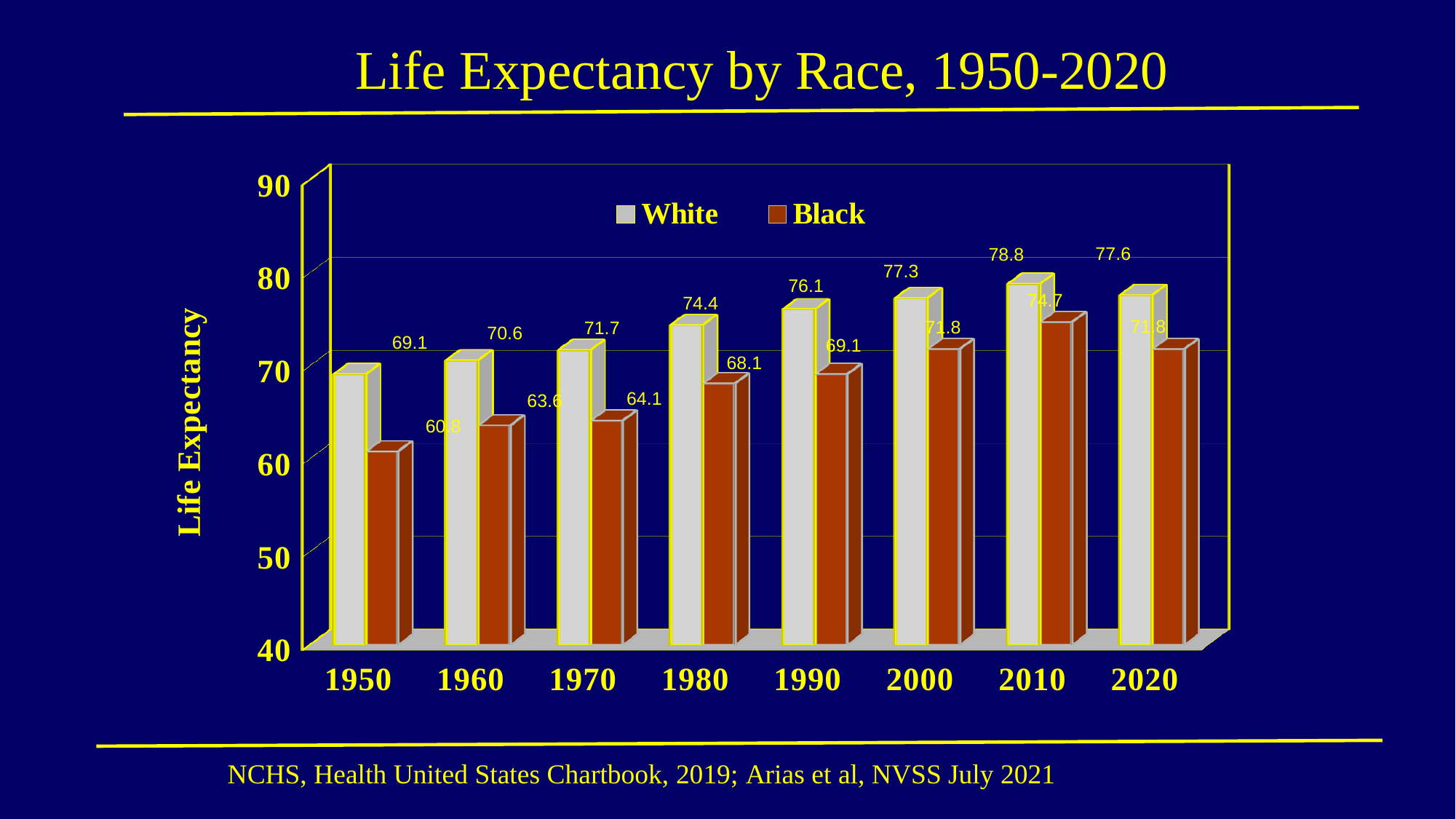
In which year is the White life expectancy highest? 2010 Is the Black life expectancy in 1970 greater or less than 70? less What is the life expectancy for White in 2010? 78.8 What is the life expectancy for Black in 1990? 69.1 What kind of chart is shown on the slide? bar chart How many years are shown on the x axis? 8 What is the difference between the White and Black life expectancy in 1990? 7.0 Which is larger, the White life expectancy in 2000 or in 2020? 2020 What is the life expectancy for Black in 2000? 71.8 What is the life expectancy for White in 1980? 74.4 How many series does the legend list? 2 In which year is the Black life expectancy lowest? 1950